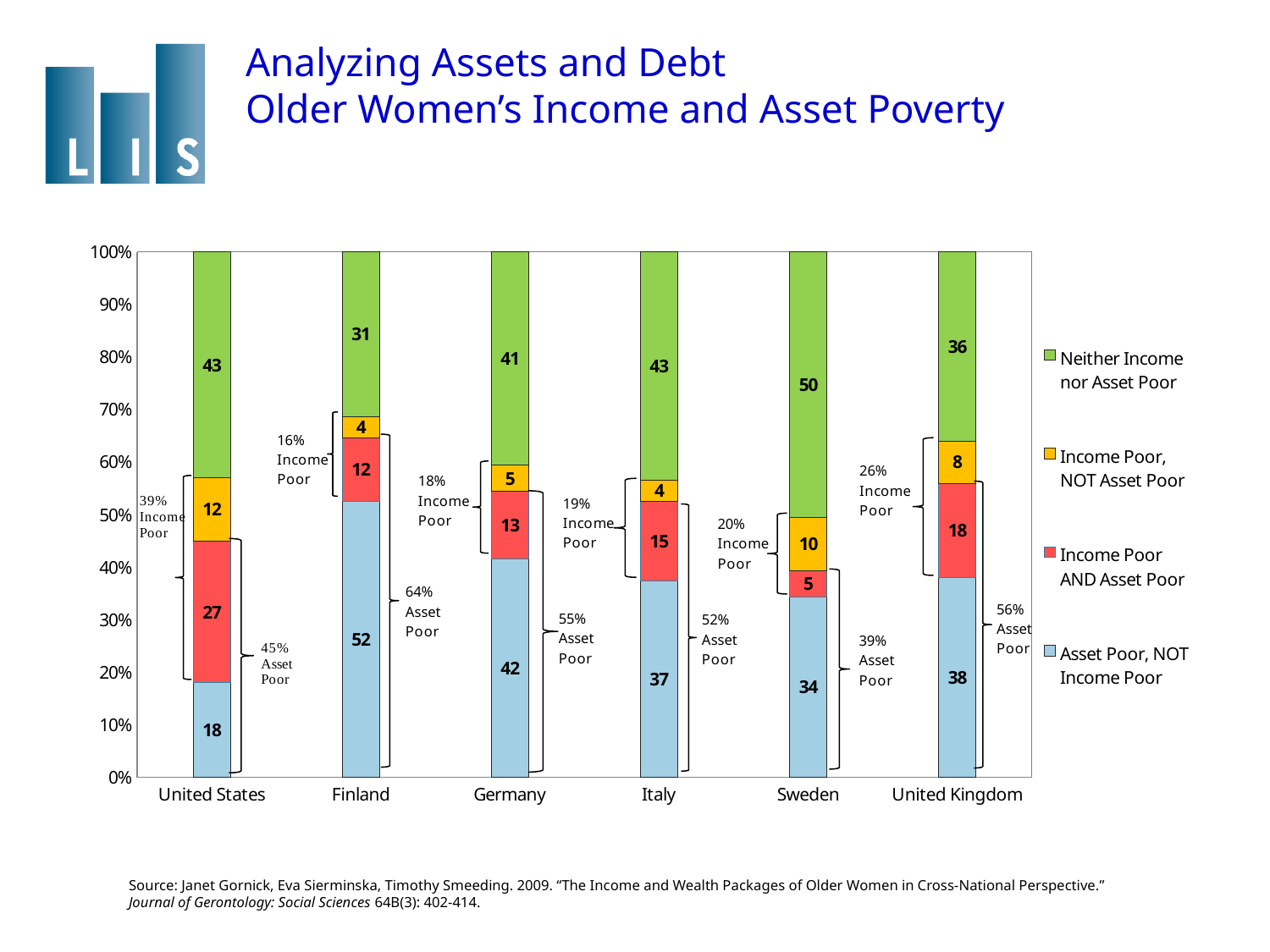
What is the value of the Income Poor, NOT Asset Poor segment for Germany? 5 Which country has the highest value for Neither Income nor Asset Poor? Sweden How many series does the legend list? 4 Which country has the highest value for Income Poor AND Asset Poor? United States What is the value of the Income Poor AND Asset Poor segment for the United Kingdom? 18 Which is larger, the Income Poor, NOT Asset Poor value for Sweden or for the United Kingdom? Sweden What kind of chart is shown on the slide? Stacked bar chart Which country has the lowest value for Asset Poor, NOT Income Poor? United States What is the value of the Neither Income nor Asset Poor segment for Sweden? 50 What is the value of the Asset Poor, NOT Income Poor segment for Finland? 52 What is the difference between the Income Poor AND Asset Poor values for the United States and Sweden? 22 How many countries are shown on the x axis? 6